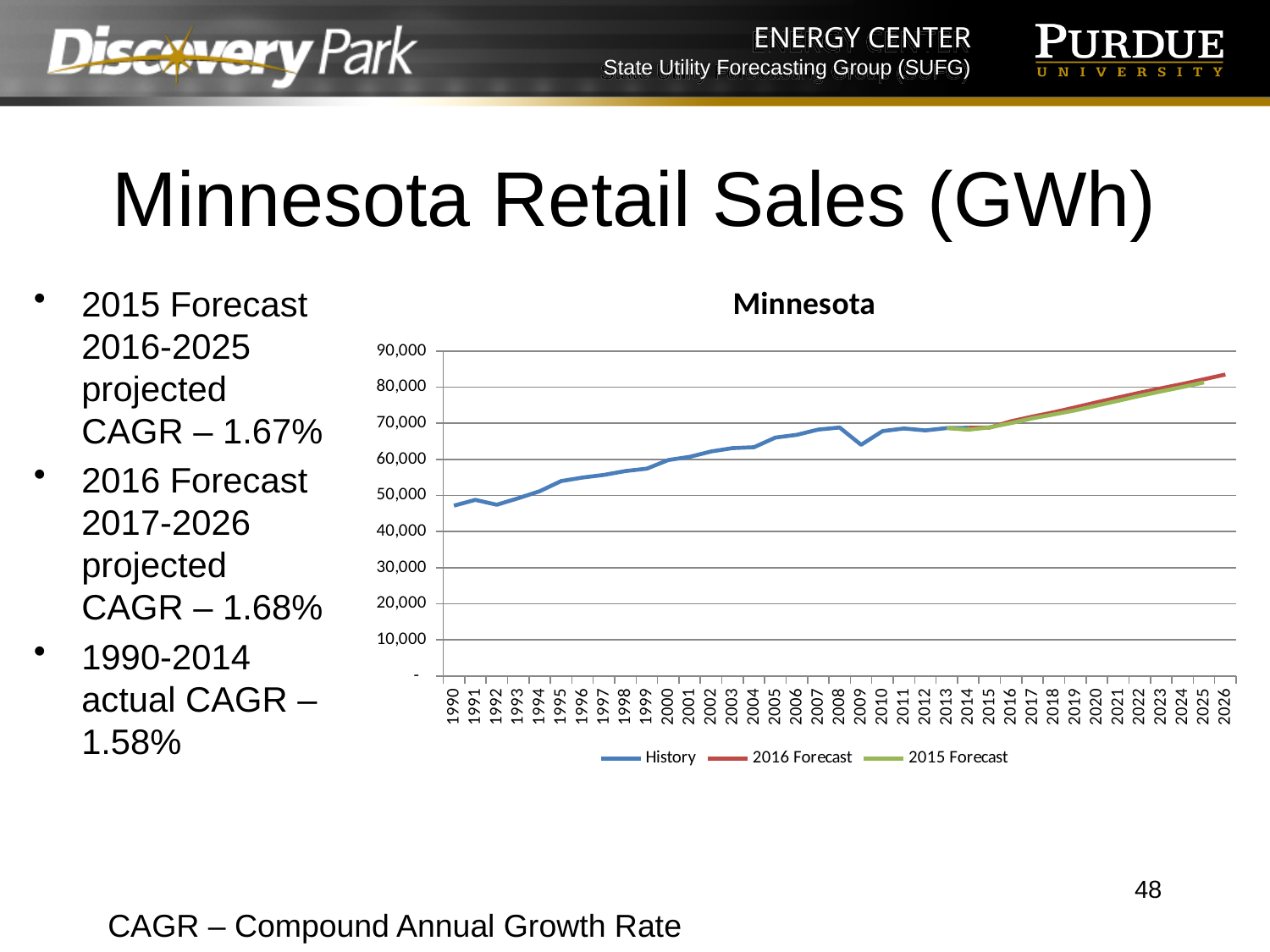
Is the History value for 1990 greater or less than 50,000? less Which year has the larger History value, 2008 or 2009? 2008 Which series are listed in the chart legend? History, 2016 Forecast, 2015 Forecast What kind of chart is shown on the slide? line chart What is the title of the chart? Minnesota Is the History value for 1995 greater or less than 50,000? greater Is the History value for 2009 greater or less than 60,000? greater How many series does the chart legend list? 3 Does the History series generally rise or fall from 1990 to 2014? rise Which year has the larger History value, 1990 or 2014? 2014